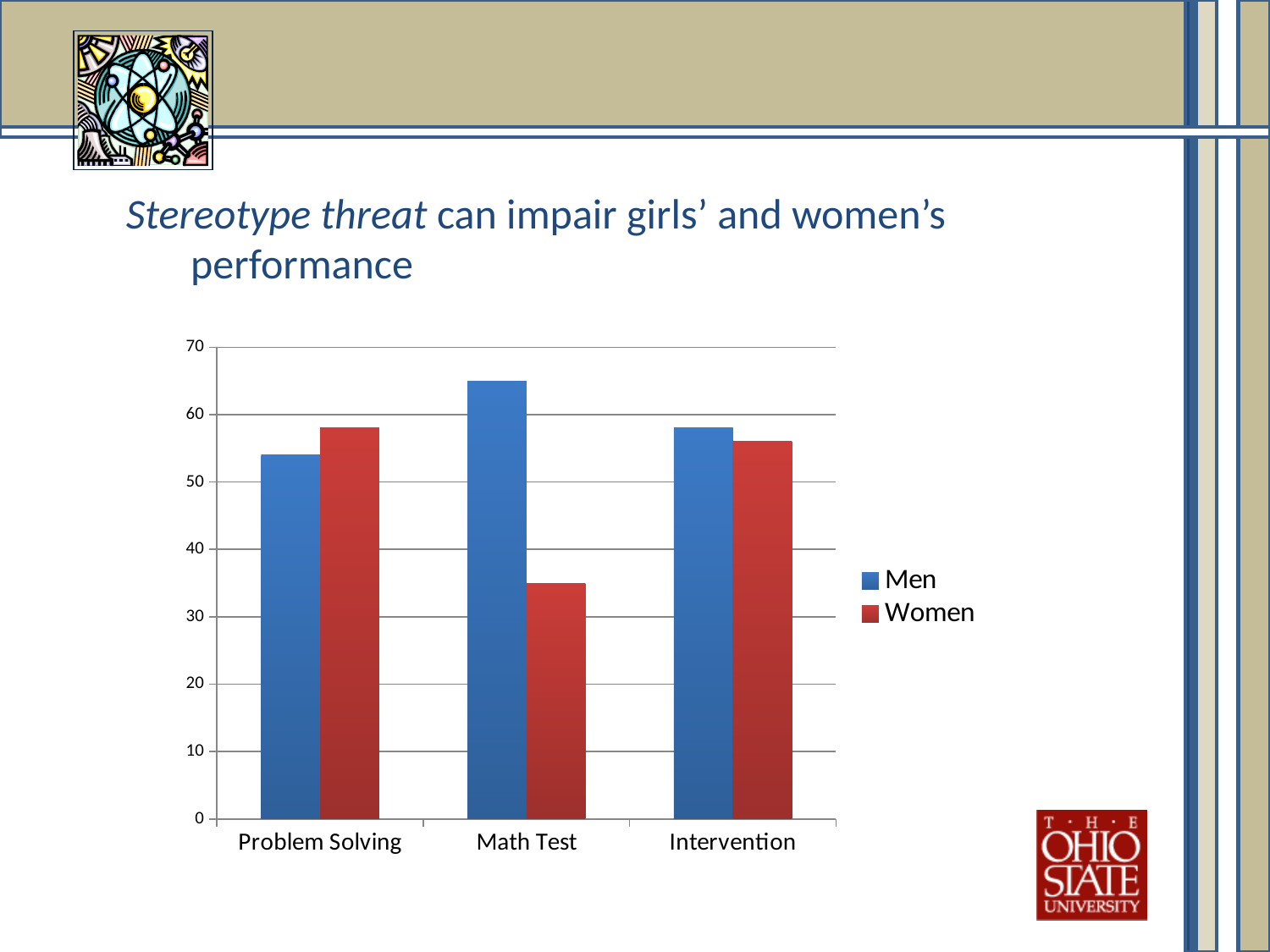
How many categories are shown on the x axis of the chart? 3 For Math Test, which is larger, the value for Men or the value for Women? Men For which category is the value for Men highest? Math Test What kind of chart is shown on the slide? bar chart Which series does the legend list first? Men For which category is the value for Women lowest? Math Test Is the value for Women in Intervention greater or less than 50? greater For Problem Solving, which is larger, the value for Men or the value for Women? Women Is the value for Women in Math Test greater or less than 40? less Is the value for Men in Math Test greater or less than 60? greater How many series does the chart's legend list? 2 Which colour represents Women in the chart? red